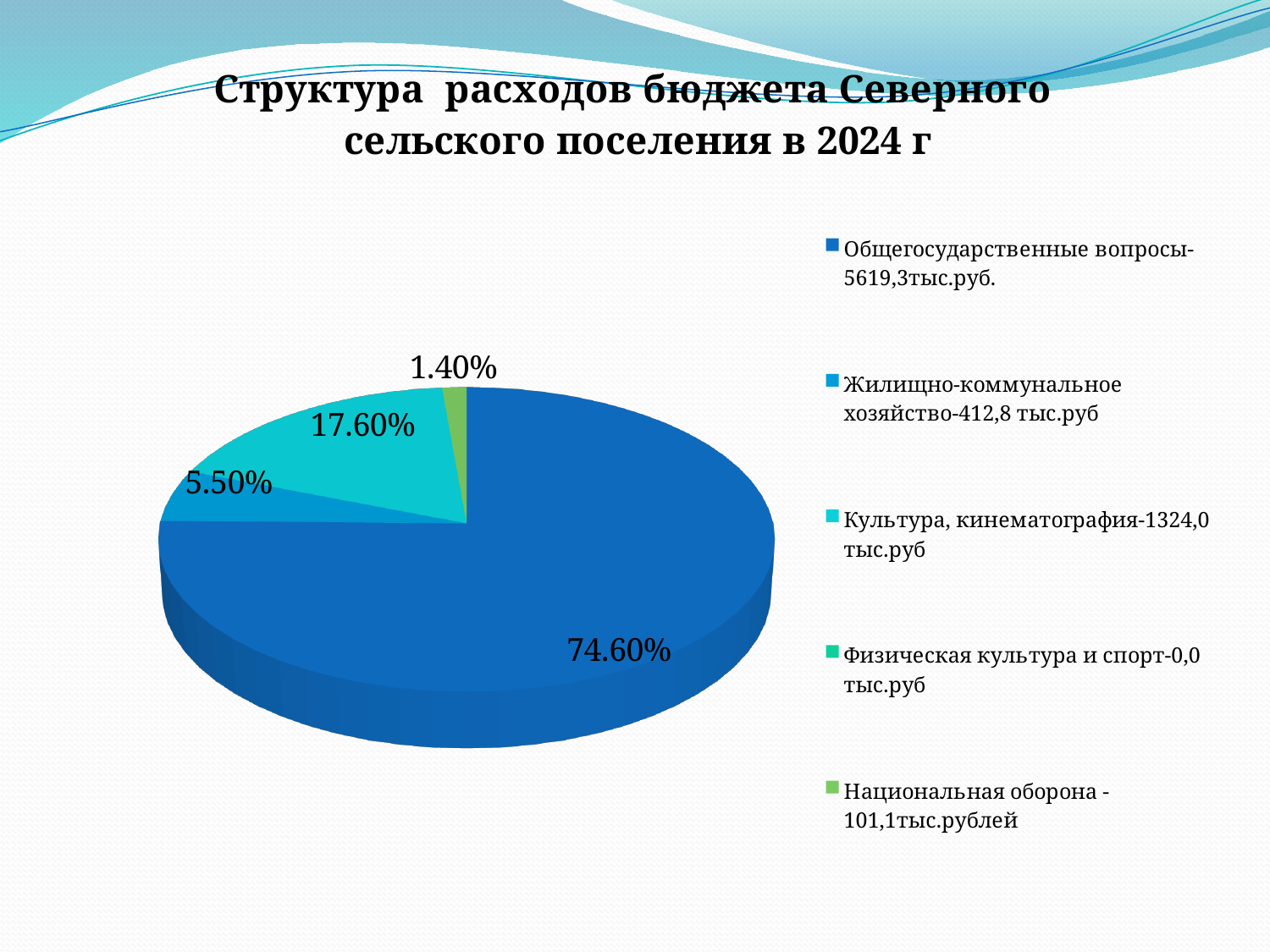
What share of the pie is labeled for Жилищно-коммунальное хозяйство? 5.50% What kind of chart is shown on the slide? pie chart How many categories does the legend list? 5 Which category has the smallest labeled slice of the pie? Национальная оборона What share of the pie is labeled for Общегосударственные вопросы? 74.60% What is the difference in percentage points between the Общегосударственные вопросы slice and the Культура, кинематография slice? 57.00% What share of the pie is labeled for Национальная оборона? 1.40% According to the legend, what amount is given for Общегосударственные вопросы? 5619,3тыс.руб. Which slice is larger: Жилищно-коммунальное хозяйство or Культура, кинематография? Культура, кинематография Which category has the largest slice of the pie? Общегосударственные вопросы What share of the pie is labeled for Культура, кинематография? 17.60% What is the title of the slide? Структура расходов бюджета Северного сельского поселения в 2024 г